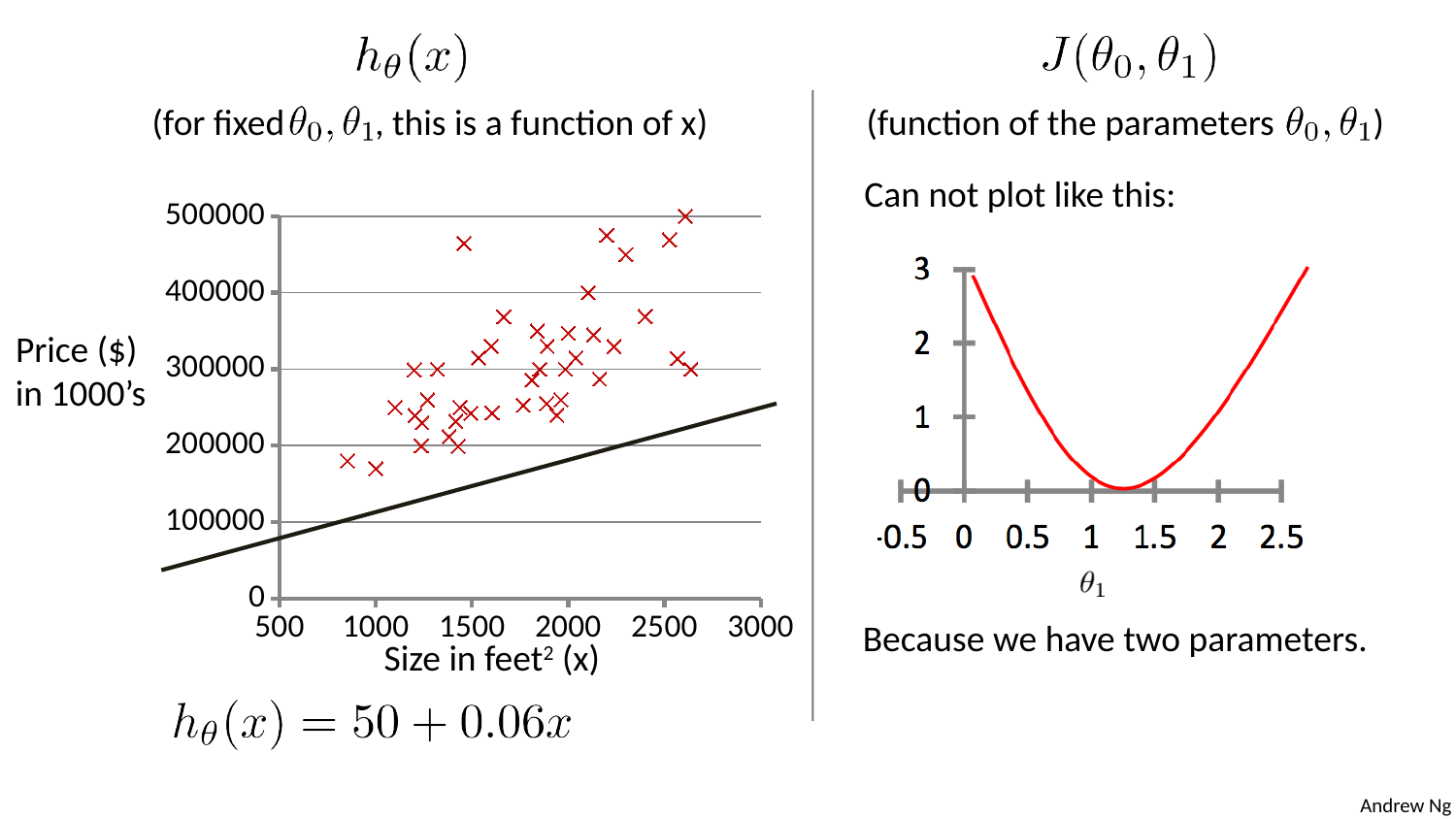
On the left chart, what is the highest value shown on the y axis? 500000 On the right chart under J(θ0, θ1), what is the highest value shown on the y axis? 3 On the left chart, is the price of the lowest plotted point greater or less than 200000? less On the left chart, what is the lowest value shown on the x axis? 500 On the left chart, how many tick labels are shown on the x axis? 6 On the left chart, does the straight line rise or fall as size increases along the x axis? rises On the right chart, is the value of the curve at θ1 = 1 greater or less than 1? less What kind of chart is the left chart under h_θ(x)? scatter chart On the right chart, what colour is the plotted curve? red On the left chart, is the price of the highest plotted point greater or less than 400000? greater On the left chart, what is the label of the x axis? Size in feet² (x)